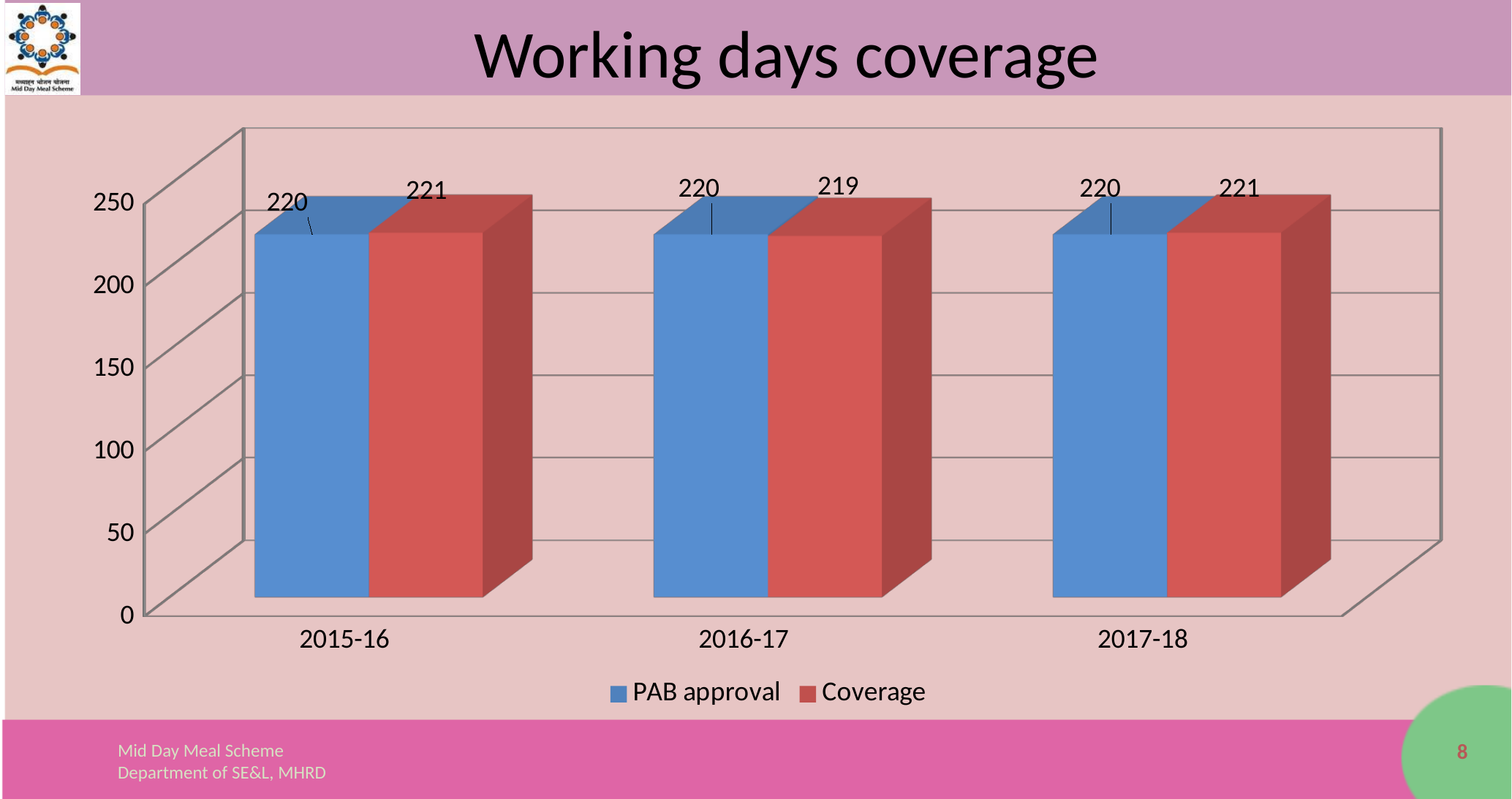
How many years are shown on the x axis? 3 What is the difference between Coverage and PAB approval in 2015-16? 1 In 2016-17, which is larger: PAB approval or Coverage? PAB approval What is the Coverage value for 2017-18? 221 What is the PAB approval value for 2015-16? 220 What type of chart is shown on the slide? Bar chart What is the PAB approval value for 2017-18? 220 What is the difference between PAB approval and Coverage in 2016-17? 1 In which year is the Coverage value lowest? 2016-17 What is the Coverage value for 2016-17? 219 In 2017-18, which is larger: PAB approval or Coverage? Coverage How many series does the legend list? 2